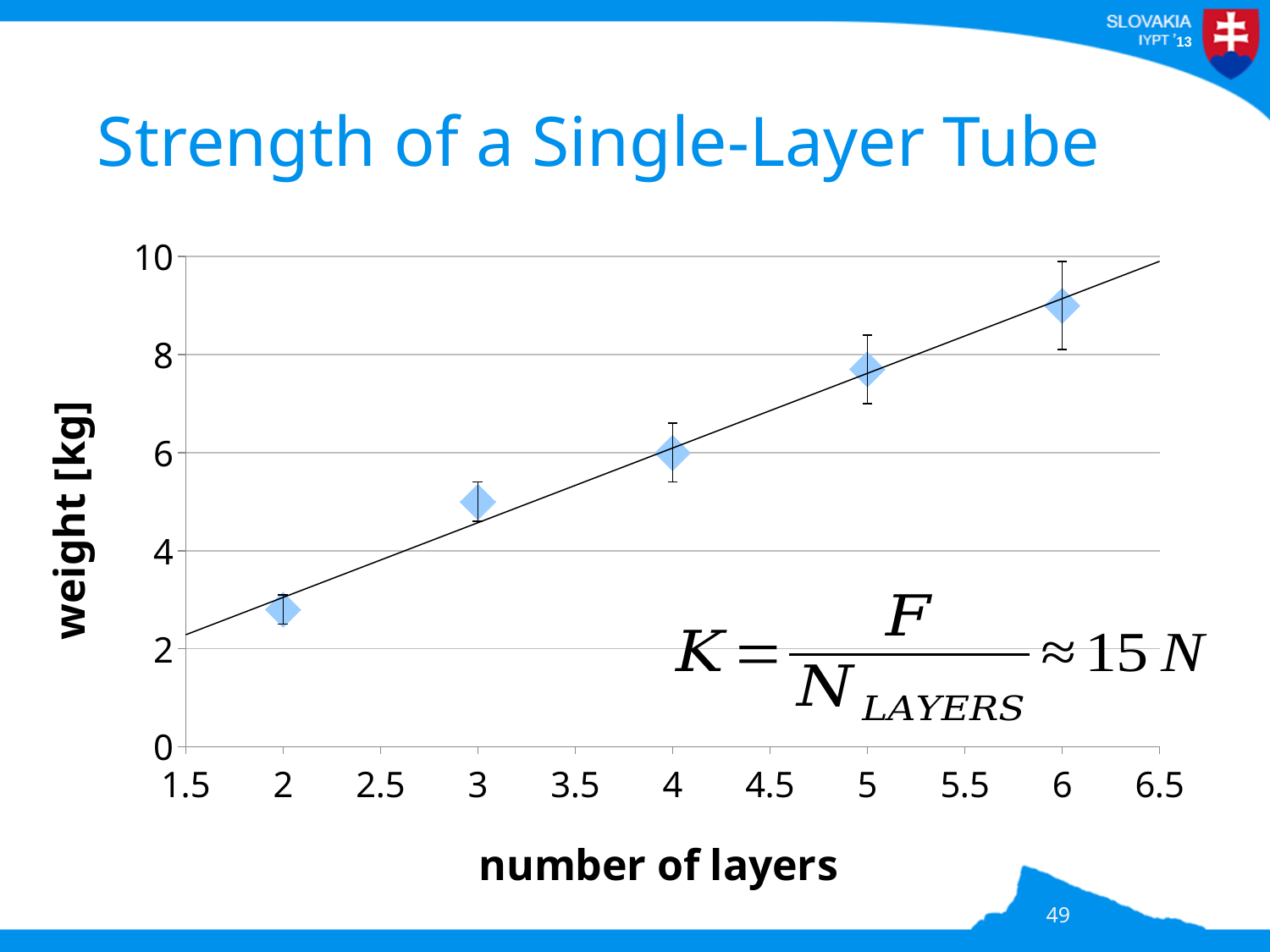
Is the weight for 5 layers greater or less than 8 kg? less Does the weight rise or fall as the number of layers increases? rises Is the weight for 6 layers greater or less than 8 kg? greater Which number of layers has the highest weight? 6 How many data points are plotted in the chart? 5 Which has a larger weight: 5 layers or 3 layers? 5 layers Is the weight for 3 layers greater or less than 4 kg? greater What kind of chart is shown on the slide? scatter plot Which number of layers has the lowest weight? 2 What is the label of the y axis? weight [kg] What is the label of the x axis? number of layers